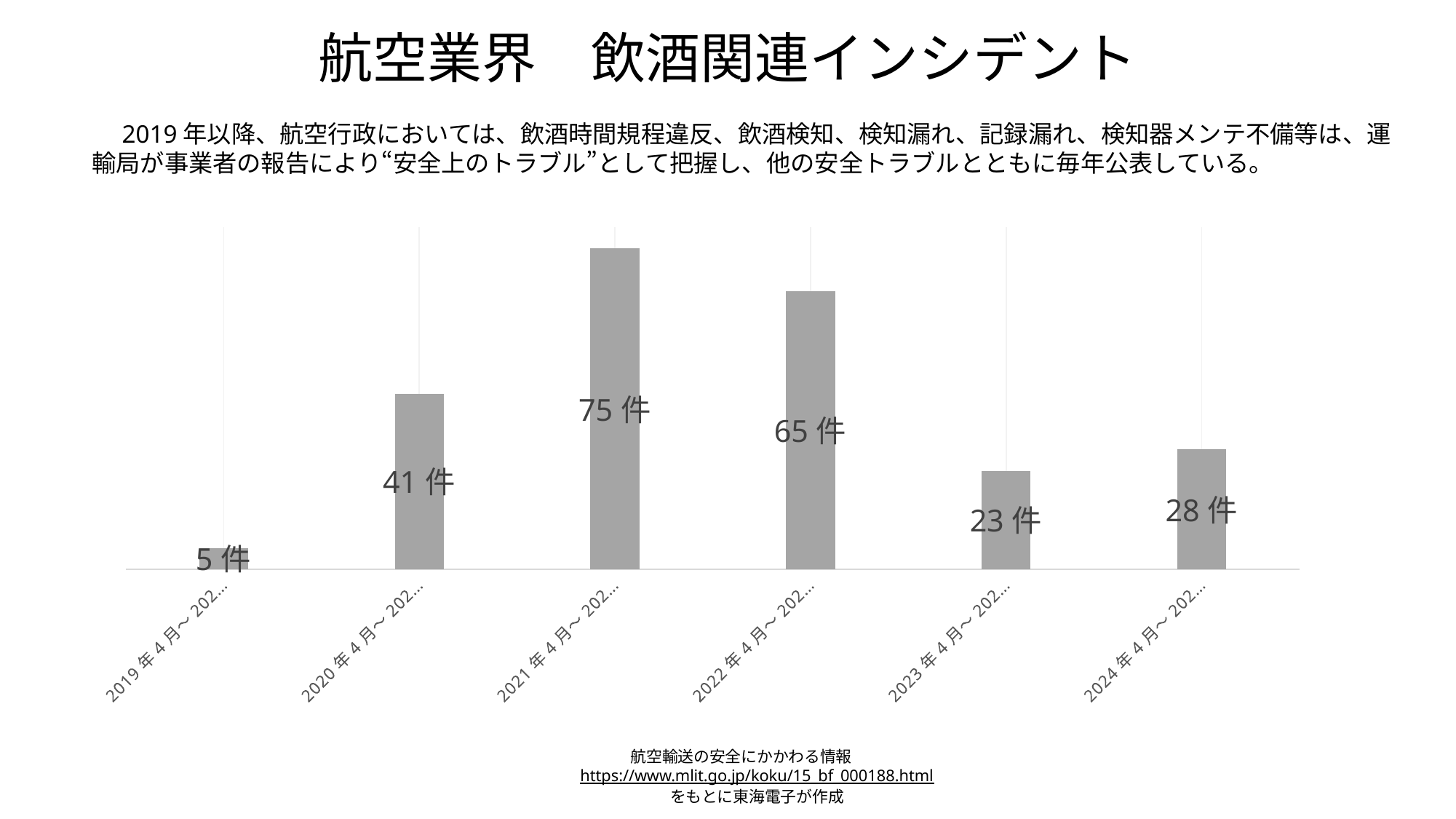
Which period has the highest value? 2021 年 4 月～ How many bars are plotted in the chart? 6 What is the value for the bar labelled 2024 年 4 月～? 28 件 What is the value for the bar labelled 2021 年 4 月～? 75 件 What is the value for the bar labelled 2019 年 4 月～? 5 件 What is the value for the bar labelled 2023 年 4 月～? 23 件 What is the difference between the values for 2021 年 4 月～ and 2022 年 4 月～? 10 件 Which period has the lowest value? 2019 年 4 月～ What is the difference between the values for 2020 年 4 月～ and 2019 年 4 月～? 36 件 Do the values rise or fall from 2021 年 4 月～ to 2023 年 4 月～? Fall Which is larger, the value for 2023 年 4 月～ or 2024 年 4 月～? 2024 年 4 月～ What kind of chart is shown on the slide? Bar chart